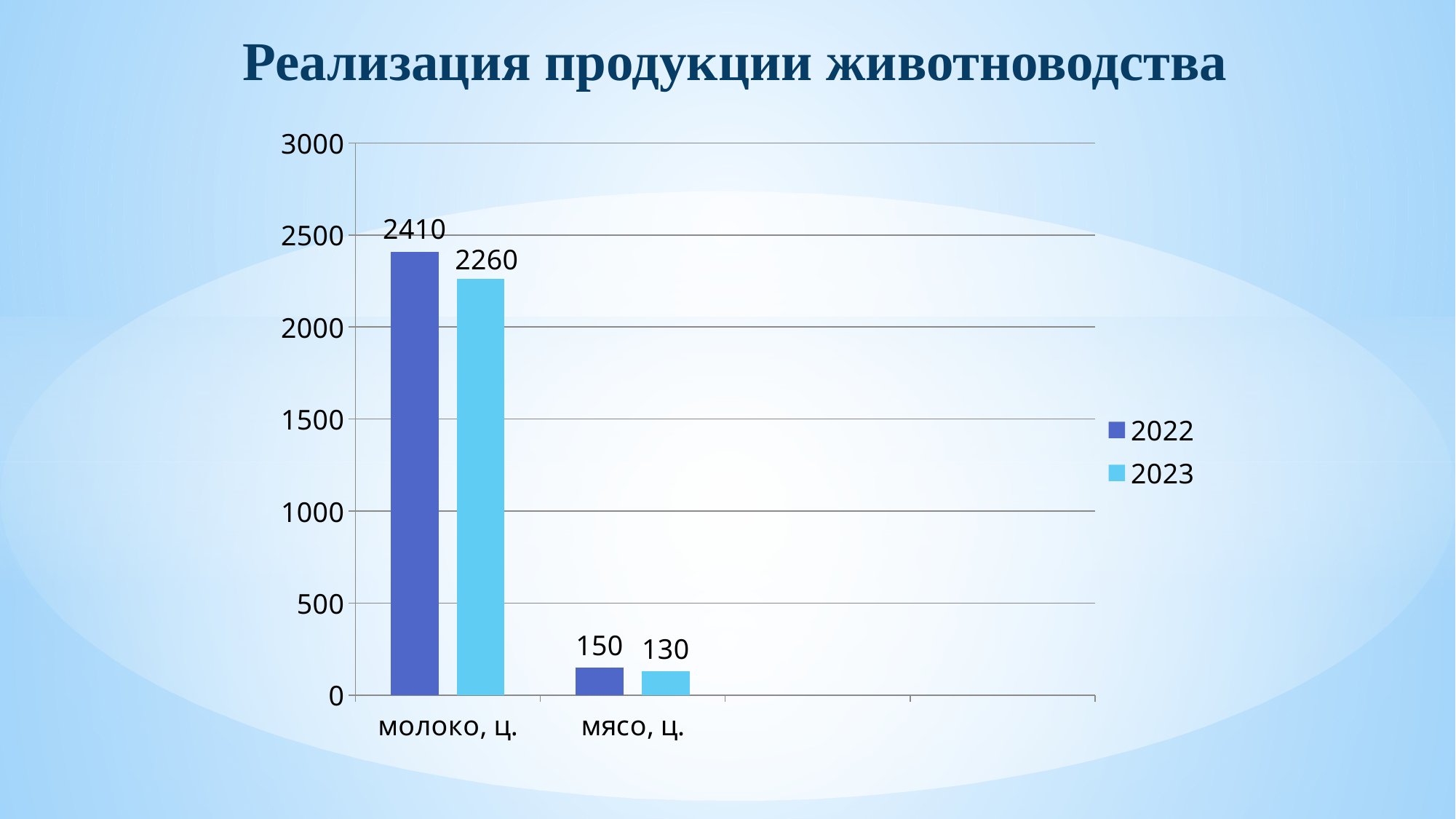
Which is larger for молоко, ц.: the 2022 value or the 2023 value? 2022 How many categories are shown on the x axis? 2 What is the value for молоко, ц. in 2022? 2410 What is the value for мясо, ц. in 2022? 150 What is the difference between the 2022 and 2023 values for молоко, ц.? 150 How many series does the legend list? 2 Which category has the highest value in the 2022 series? молоко, ц. What kind of chart is shown on the slide? bar chart What is the difference between the 2022 and 2023 values for мясо, ц.? 20 Which category has the lowest value in the 2023 series? мясо, ц. What is the value for мясо, ц. in 2023? 130 What is the value for молоко, ц. in 2023? 2260